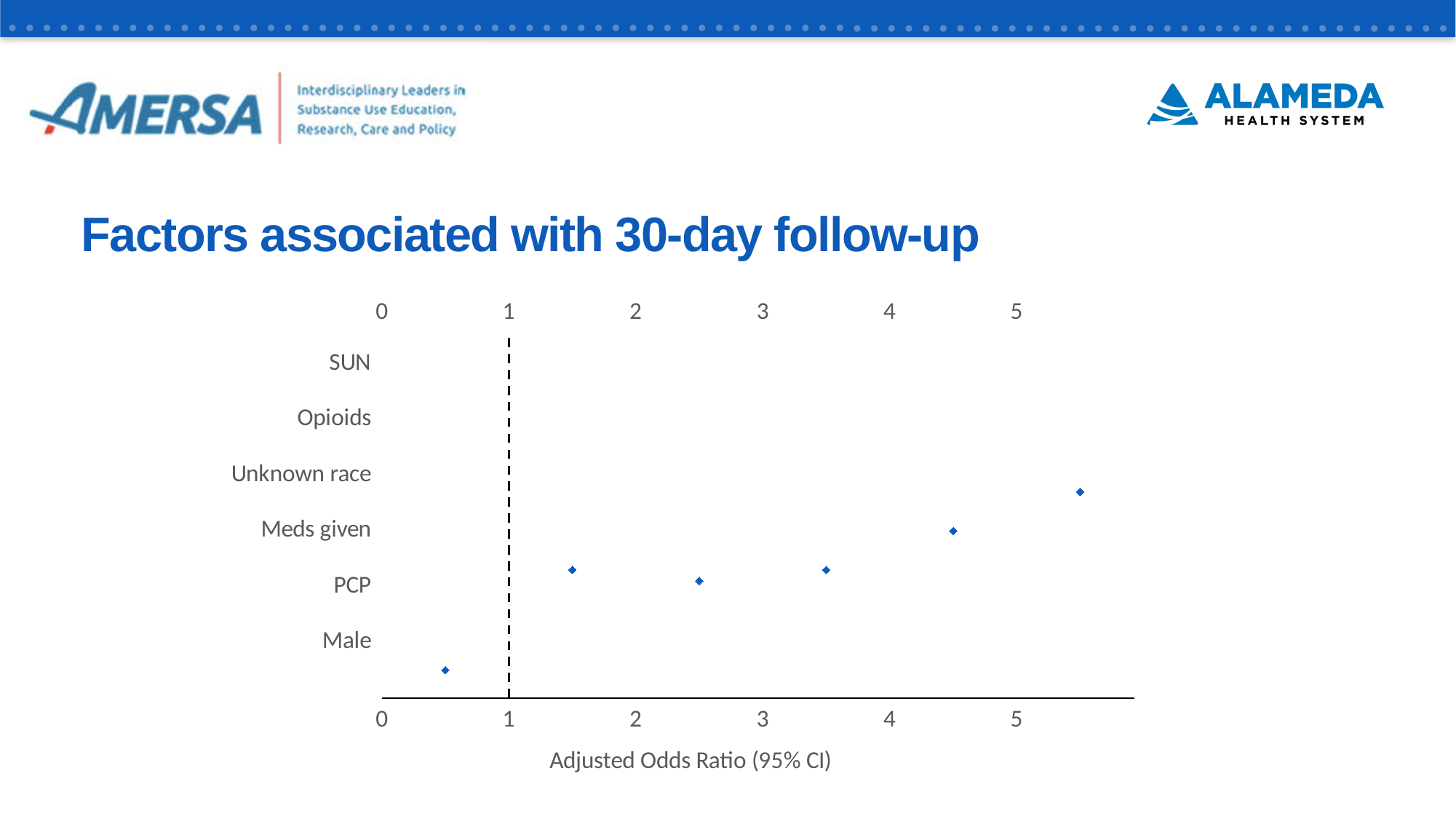
What is the highest tick value labelled on the horizontal axis? 5 At what value on the horizontal axis is the dashed vertical reference line drawn? 1 How many category labels are listed on the vertical axis of the chart? 6 How many plotted points lie to the right of the dashed line at 1? 5 Is the value of the leftmost plotted point greater or less than 1? less Is the value of the rightmost plotted point greater or less than 5? greater What kind of chart is shown on the slide? scatter plot What is the label of the horizontal axis? Adjusted Odds Ratio (95% CI) How many data points are plotted on the chart? 6 Which category label appears at the top of the vertical axis? SUN What is the title of the chart on the slide? Factors associated with 30-day follow-up